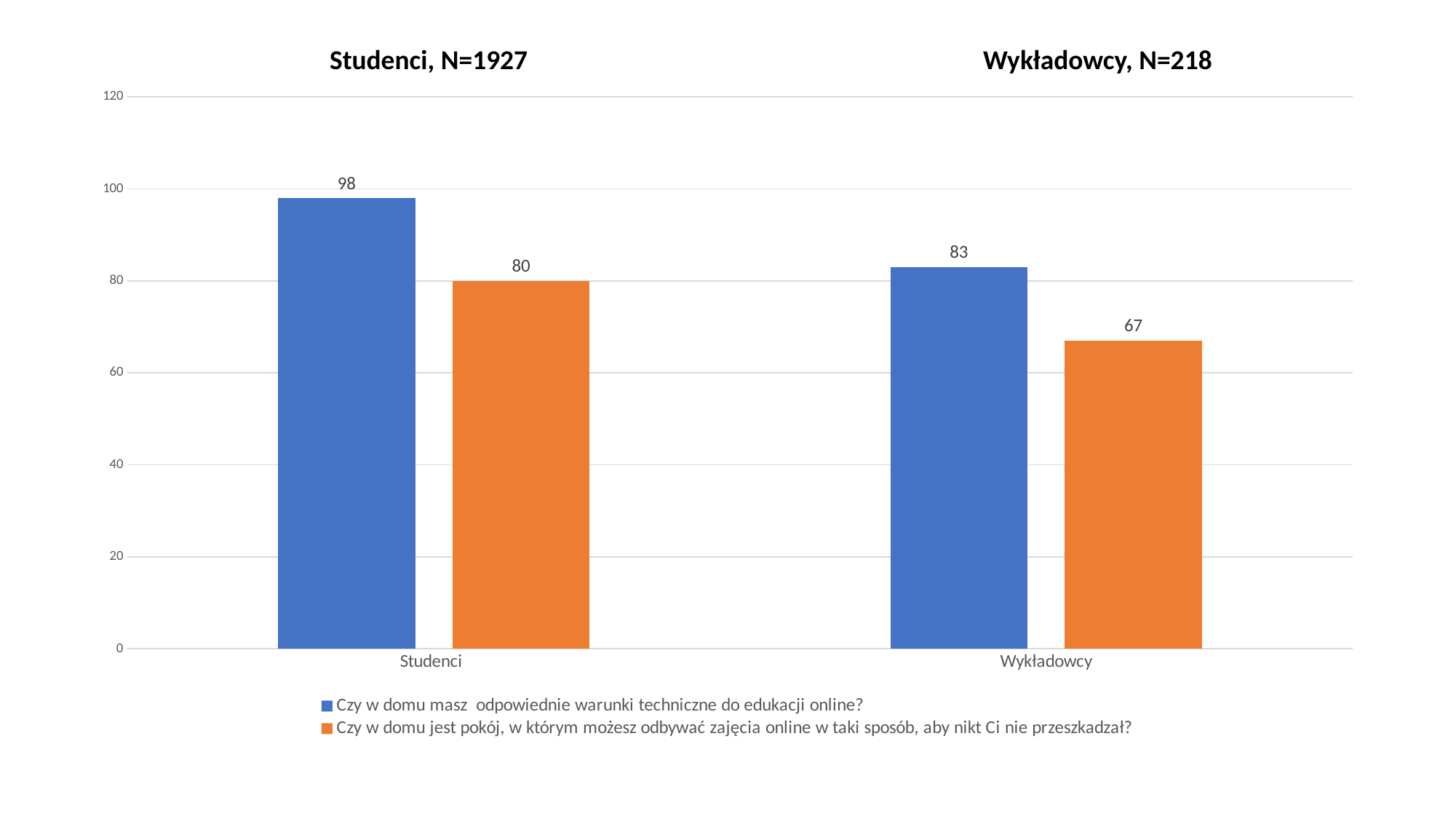
Which bar has the lowest value on the chart? Wykładowcy, Czy w domu jest pokój, w którym możesz odbywać zajęcia online w taki sposób, aby nikt Ci nie przeszkadzał? Which is larger: the Studenci value for "Czy w domu jest pokój..." or the Wykładowcy value for "Czy w domu masz odpowiednie warunki techniczne..."? Wykładowcy value for "Czy w domu masz odpowiednie warunki techniczne..." (83) What is the value for Studenci for the series "Czy w domu masz odpowiednie warunki techniczne do edukacji online?"? 98 What is the value for Studenci for the series "Czy w domu jest pokój, w którym możesz odbywać zajęcia online w taki sposób, aby nikt Ci nie przeszkadzał?"? 80 What is the difference between the Studenci and Wykładowcy values for the series "Czy w domu masz odpowiednie warunki techniczne do edukacji online?"? 15 Which bar has the highest value on the chart? Studenci, Czy w domu masz odpowiednie warunki techniczne do edukacji online? What is the difference between the two series values for Wykładowcy? 16 How many series does the legend list? 2 What is the value for Wykładowcy for the series "Czy w domu jest pokój, w którym możesz odbywać zajęcia online w taki sposób, aby nikt Ci nie przeszkadzał?"? 67 What kind of chart is shown on the slide? Bar chart How many categories are shown on the x axis? 2 What is the value for Wykładowcy for the series "Czy w domu masz odpowiednie warunki techniczne do edukacji online?"? 83